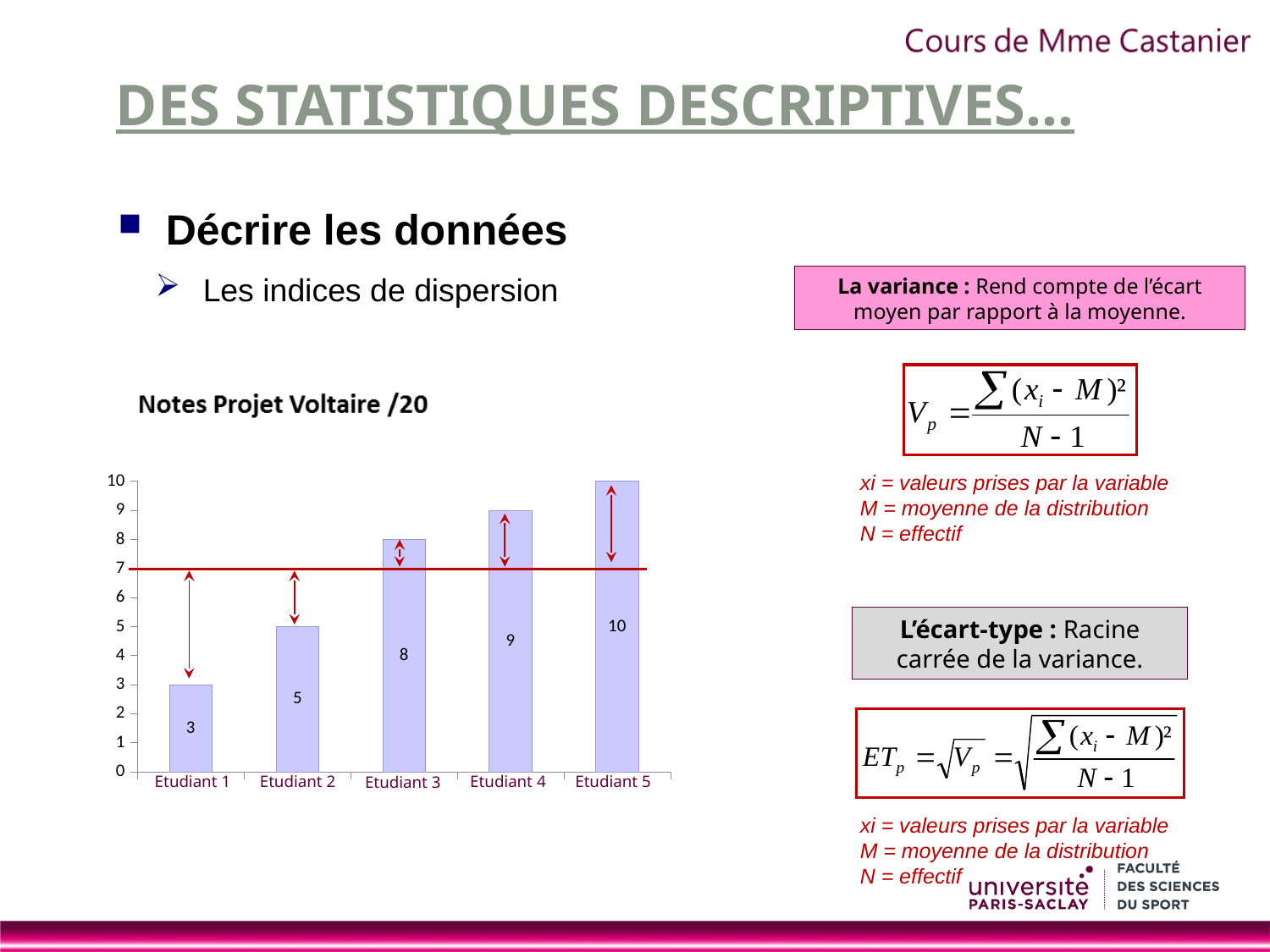
Which student has the highest value? Etudiant 5 Which student has the lowest value? Etudiant 1 What is the value for Etudiant 5? 10 Which is larger, the value for Etudiant 2 or the value for Etudiant 3? Etudiant 3 What is the difference between the values for Etudiant 4 and Etudiant 2? 4 What is the title of the chart? Notes Projet Voltaire /20 What is the value for Etudiant 1? 3 How many students are shown on the x axis? 5 Is the value for Etudiant 4 greater or less than 7? greater What is the value for Etudiant 3? 8 Do the values rise or fall from Etudiant 1 to Etudiant 5? rise What kind of chart is shown? bar chart